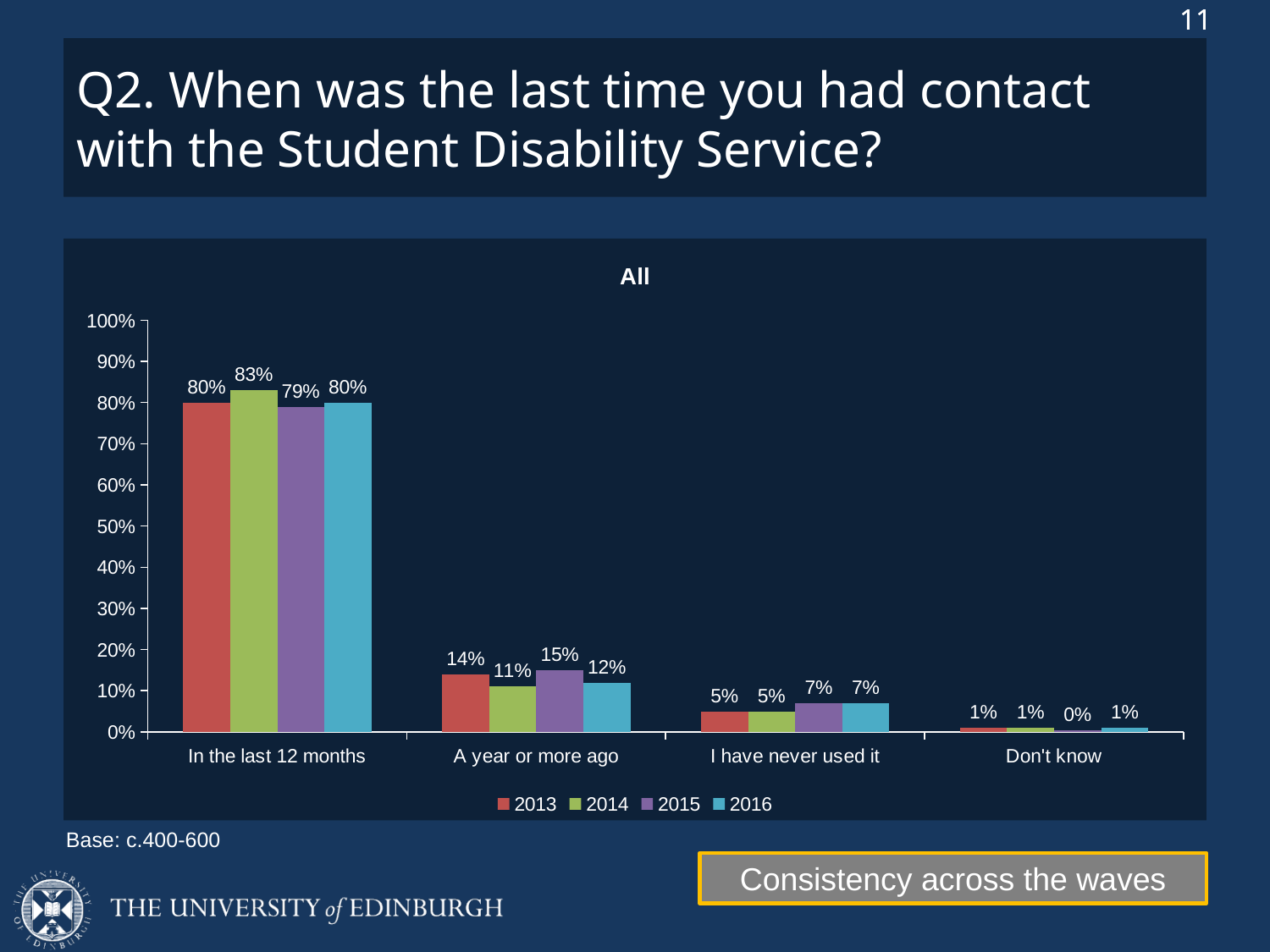
What is the value for 2014 in the 'In the last 12 months' category? 83% How many categories are shown on the x axis? 4 How many series does the legend list? 4 Which year has the highest value in the 'In the last 12 months' category? 2014 What is the value for 2016 in the 'I have never used it' category? 7% What is the title shown above the chart? All What is the difference between the 2014 and 2015 values in the 'In the last 12 months' category? 4 percentage points Which is larger: the 2013 value or the 2016 value for 'A year or more ago'? 2013 What is the value for 2015 in the 'A year or more ago' category? 15% Which year has the lowest value in the 'A year or more ago' category? 2014 What is the value for 2015 in the 'Don't know' category? 0% What kind of chart is shown on the slide? Bar chart